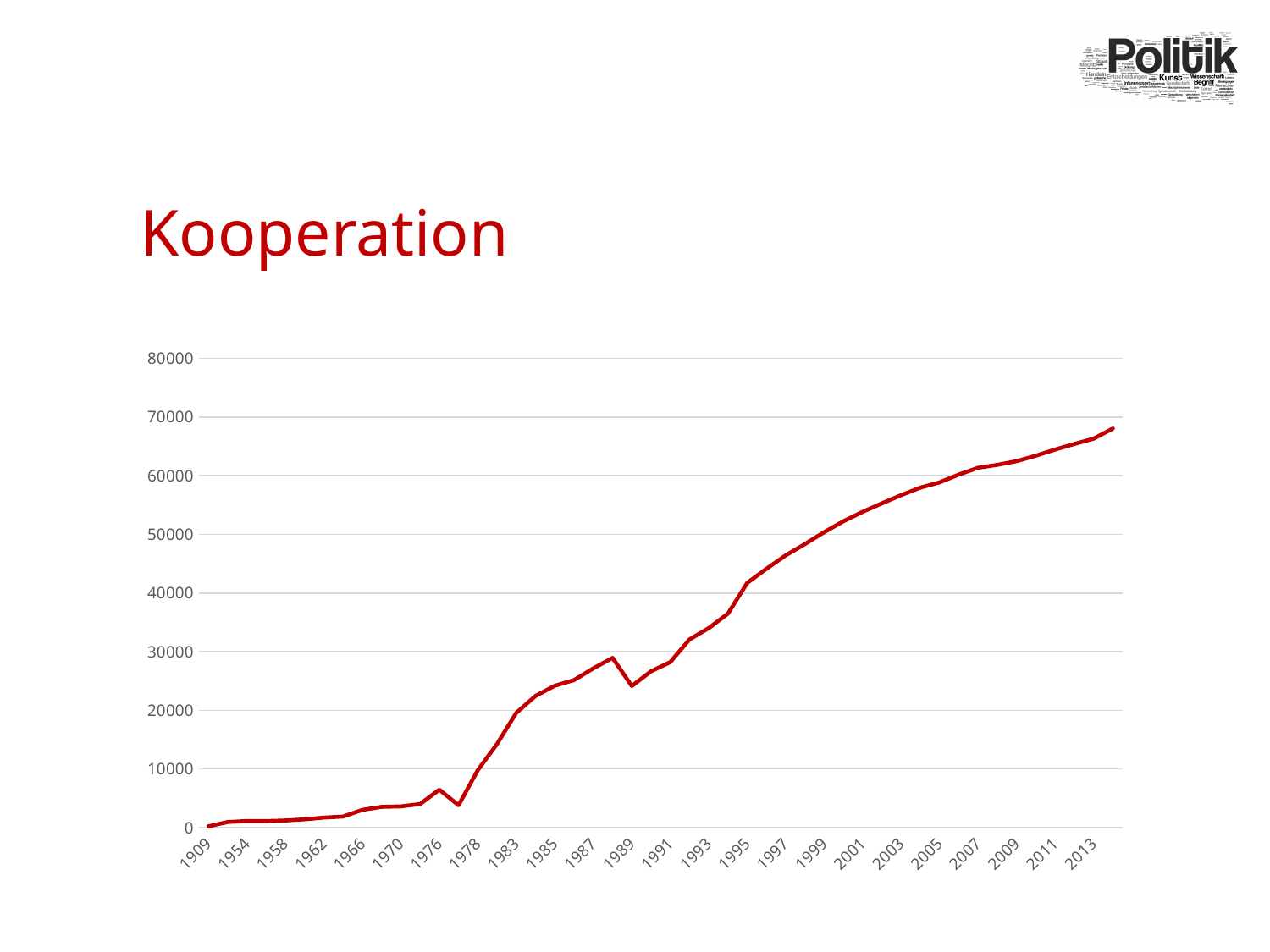
Is the value for 2001 greater or less than 50000? greater Which year on the x axis has the lowest value? 1909 Do the values generally rise or fall from 1909 to 2013? rise What colour is the line in the chart? red Which year on the x axis has the highest value? 2013 What kind of chart is shown on the slide? line chart Is the value for 2013 greater or less than 60000? greater Is the value for 1989 greater or less than 30000? less What is the title shown above the chart? Kooperation Which is larger, the value for 1995 or the value for 1989? 1995